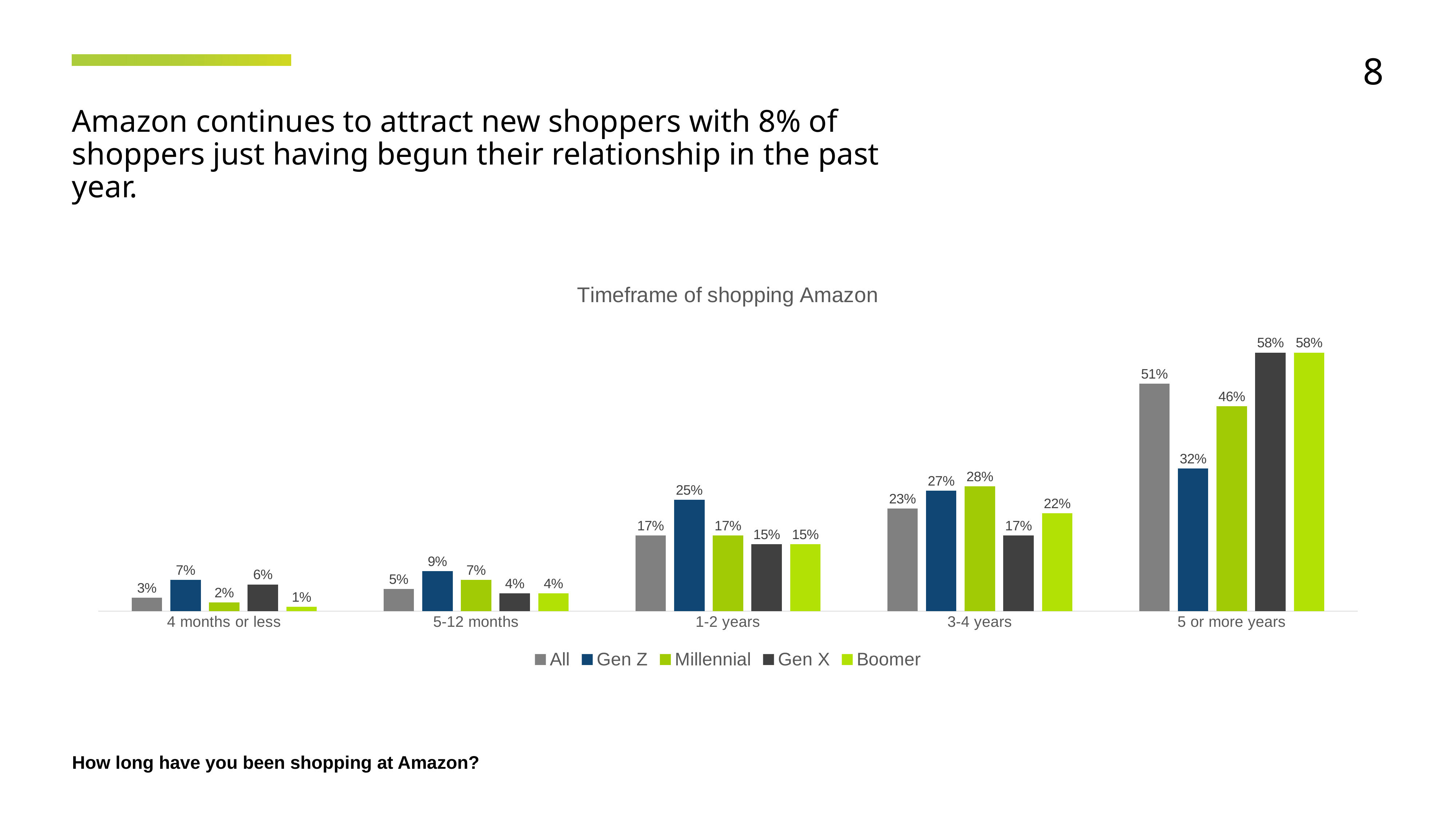
What is the title of the chart? Timeframe of shopping Amazon What kind of chart is shown on the slide? Bar chart How many categories are shown on the x axis? 5 Which series has the highest value in the 3-4 years category? Millennial What is the difference between the Gen Z and Millennial values in the 5 or more years category? 14% Which series has the lowest value in the 5 or more years category? Gen Z Which is larger in the 1-2 years category, the Gen Z value or the Gen X value? Gen Z How many series does the legend list? 5 What is the value for Gen Z in the 4 months or less category? 7% Do the values for the All series rise or fall from 4 months or less to 5 or more years? Rise What is the value for Boomer in the 5 or more years category? 58% What is the value for All in the 1-2 years category? 17%